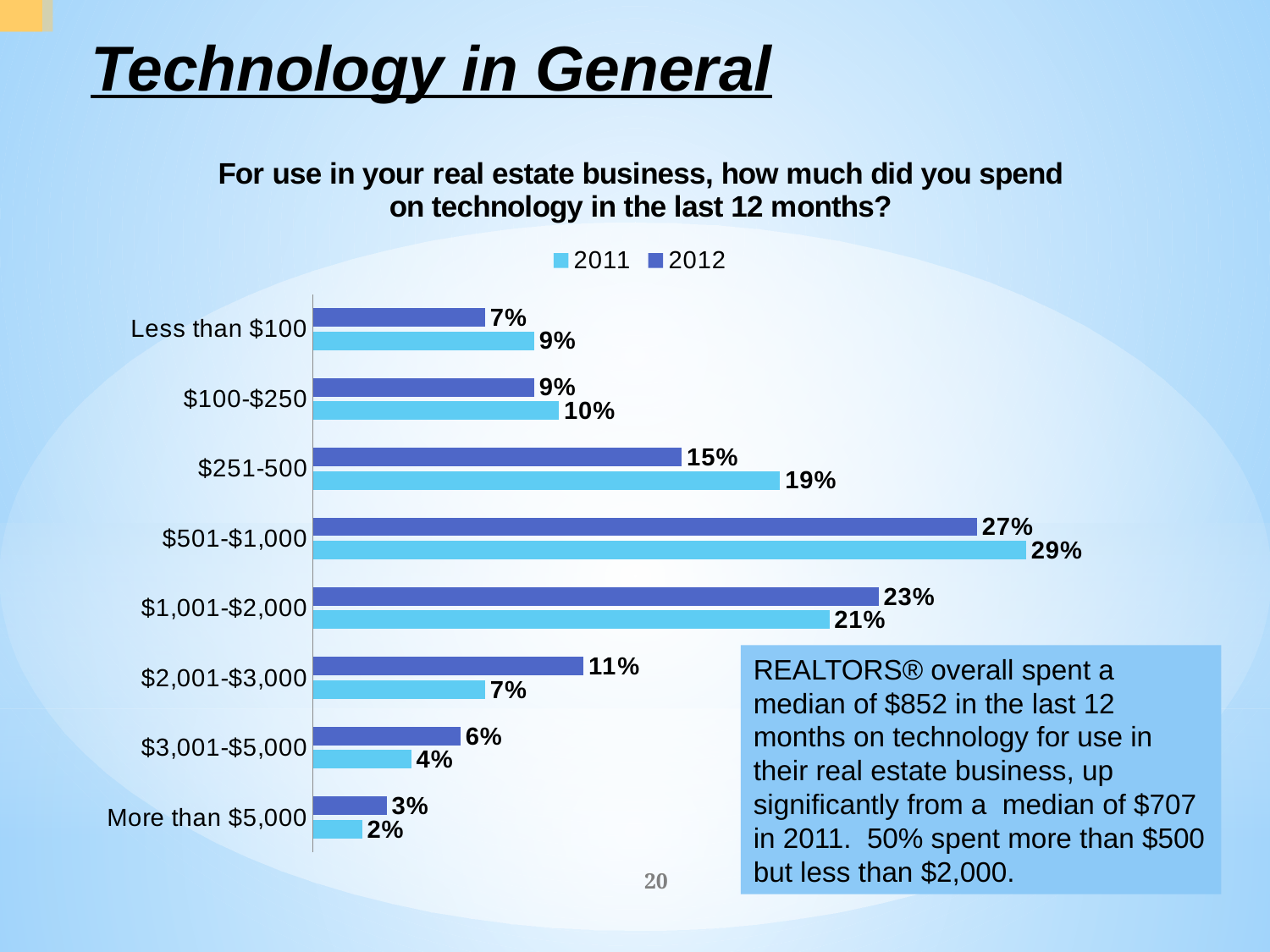
For the Less than $100 category, which year has the larger value, 2011 or 2012? 2011 Which spending category has the highest value for 2011? $501-$1,000 How many series does the legend list? 2 What is the difference between the 2012 and 2011 values for the $3,001-$5,000 category? 2% Which spending category has the lowest value for 2012? More than $5,000 What percentage of respondents spent $501-$1,000 on technology in 2012? 27% What is the difference between the 2011 and 2012 values for the $251-500 category? 4% For the $1,001-$2,000 category, which year has the larger value, 2011 or 2012? 2012 What percentage of respondents spent $251-500 on technology in 2011? 19% What type of chart is shown on the slide? Bar chart How many spending categories are shown on the chart? 8 What is the 2012 value for the $2,001-$3,000 category? 11%